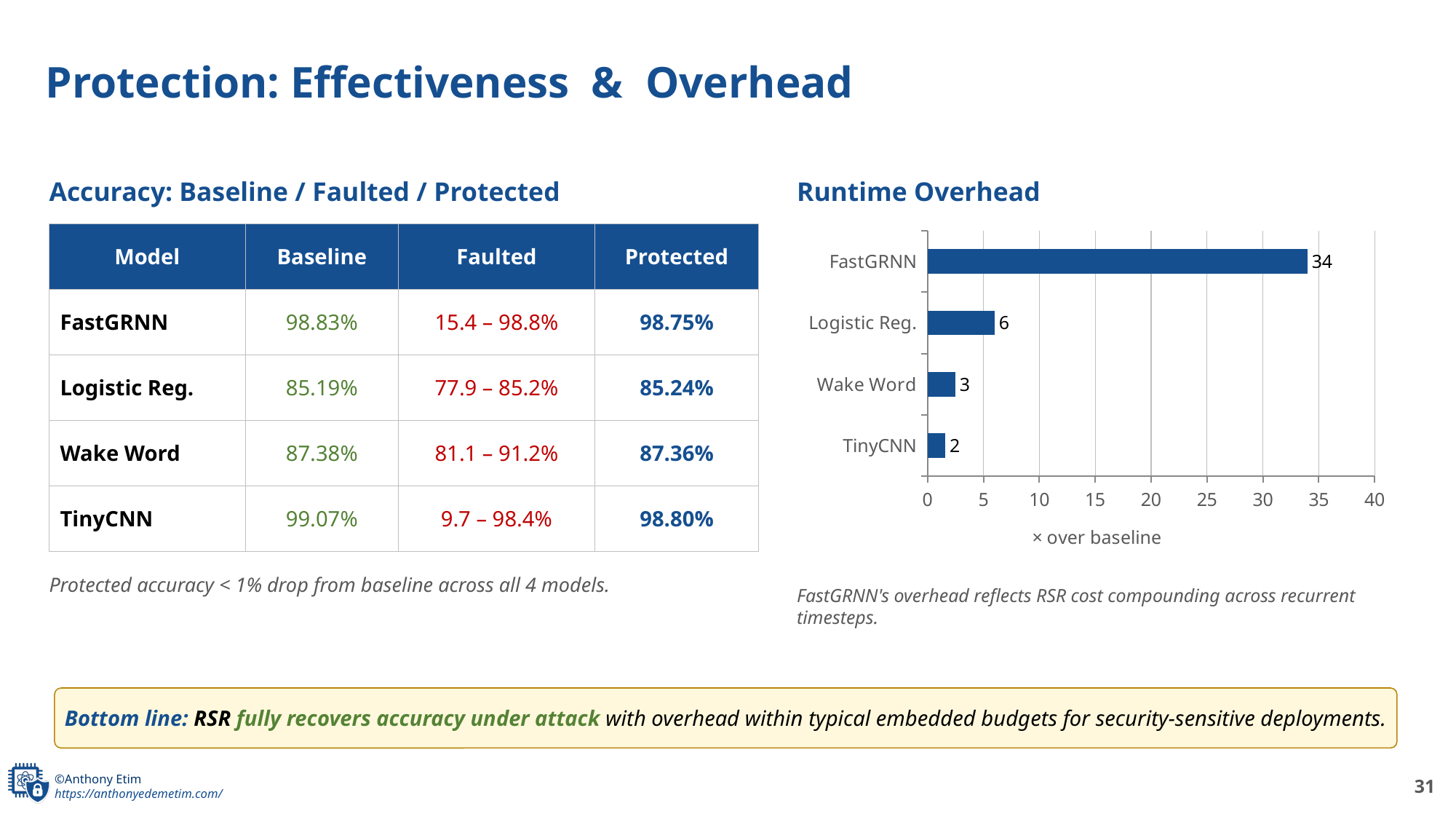
In the Runtime Overhead chart, what is the difference between the FastGRNN and Logistic Reg. values? 28 In the Runtime Overhead chart, which model has the highest overhead? FastGRNN In the Runtime Overhead chart, what is the value for Wake Word? 3 In the Runtime Overhead chart, which is larger, the value for Wake Word or the value for TinyCNN? Wake Word What is the x-axis label of the Runtime Overhead chart? × over baseline In the Runtime Overhead chart, what is the value for TinyCNN? 2 In the Runtime Overhead chart, what is the value for Logistic Reg.? 6 In the Runtime Overhead chart, is the value for FastGRNN greater or less than 30? greater How many models are plotted in the Runtime Overhead chart? 4 In the Runtime Overhead chart, which model has the lowest overhead? TinyCNN In the Runtime Overhead chart, what is the value for FastGRNN? 34 What kind of chart is the Runtime Overhead chart? bar chart